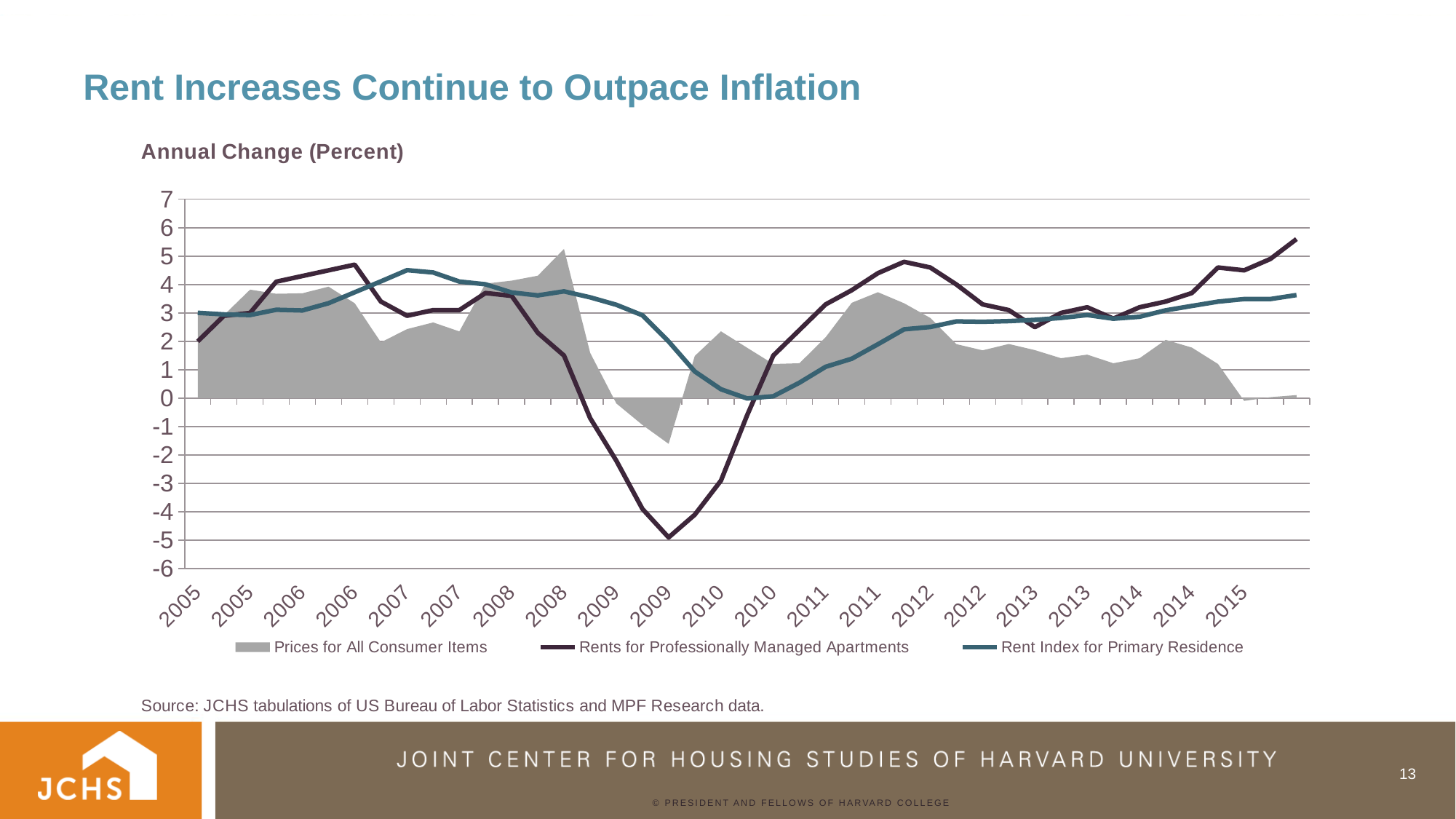
What are the first and last years shown on the x axis? 2005 and 2015 What kind of chart is shown on the slide? combination area and line chart At the end of the series in 2015, which is higher: Rents for Professionally Managed Apartments or Rent Index for Primary Residence? Rents for Professionally Managed Apartments From 2013 to 2015, do the values for Rents for Professionally Managed Apartments rise or fall? rise Which series reaches the lowest value on the chart? Rents for Professionally Managed Apartments Is the final 2015 value of Rents for Professionally Managed Apartments greater or less than 5? greater Is the 2015 value of Prices for All Consumer Items greater or less than 1? less Is the final 2015 value of Rent Index for Primary Residence greater or less than 3? greater What label appears above the chart describing the units plotted? Annual Change (Percent) How many series does the legend list? 3 Which series is drawn as a shaded gray area? Prices for All Consumer Items